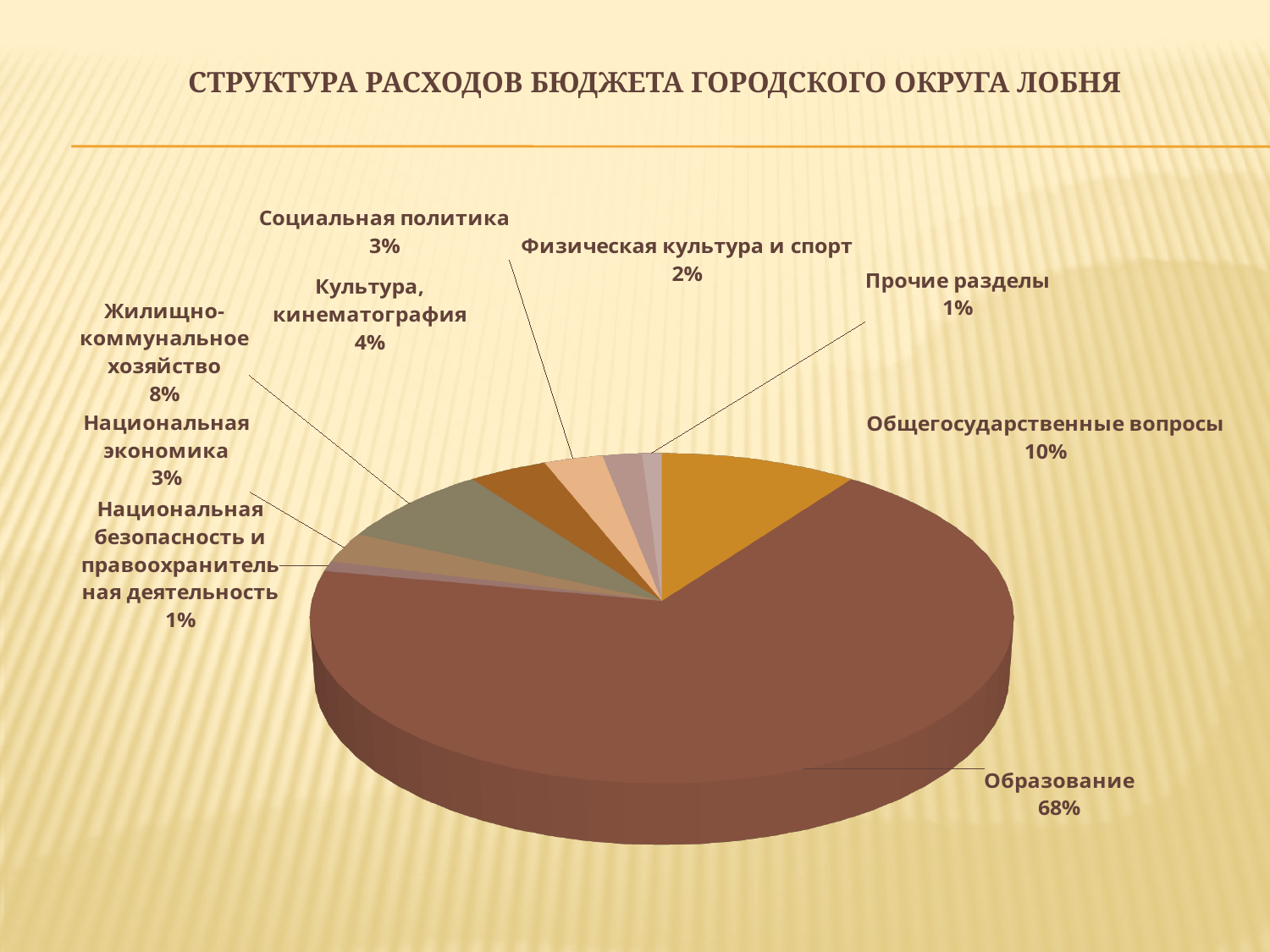
What is the value for Общегосударственные вопросы? 10% Which is larger, the share for Жилищно-коммунальное хозяйство or the share for Культура, кинематография? Жилищно-коммунальное хозяйство What is the value for Жилищно-коммунальное хозяйство? 8% What is the difference between the shares of Образование and Общегосударственные вопросы? 58% Which category has the largest share of the budget expenditure? Образование What is the title of the slide? СТРУКТУРА РАСХОДОВ БЮДЖЕТА ГОРОДСКОГО ОКРУГА ЛОБНЯ What kind of chart is shown on the slide? pie chart What is the value for Культура, кинематография? 4% What is the difference between the shares of Жилищно-коммунальное хозяйство and Социальная политика? 5% What share of the budget expenditure goes to Образование? 68% What is the value for Физическая культура и спорт? 2% How many categories are shown in the pie chart? 9